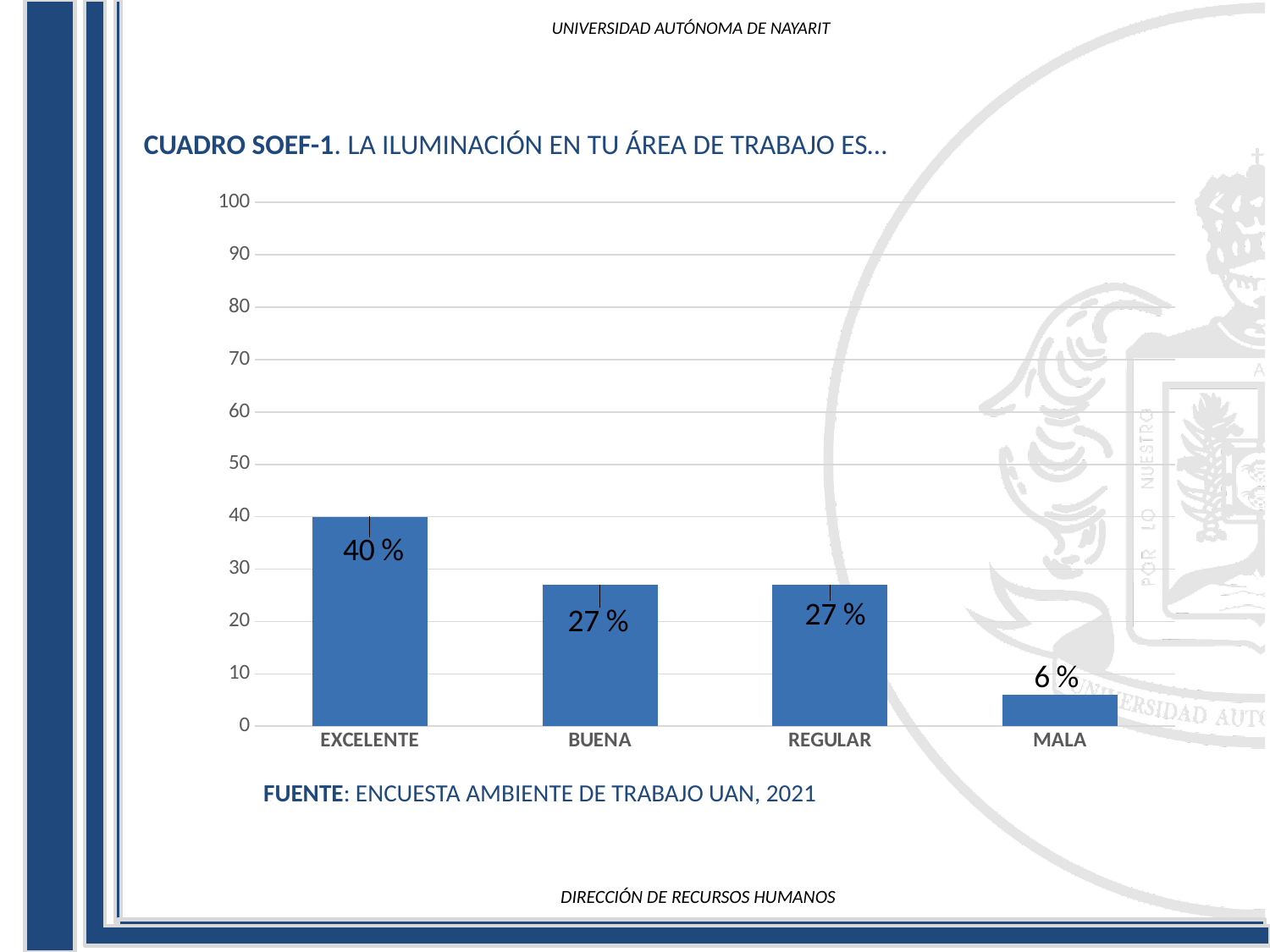
What is the value for EXCELENTE? 40 % Is the value for EXCELENTE greater or less than 30? greater What is the value for MALA? 6 % How many categories are shown on the x axis? 4 Which is larger, the value for BUENA or the value for MALA? BUENA Which category has the lowest value? MALA Which category has the highest value? EXCELENTE What is the source cited below the chart? ENCUESTA AMBIENTE DE TRABAJO UAN, 2021 What kind of chart is shown on the slide? bar chart What is the difference between the values for EXCELENTE and REGULAR? 13 % What is the value for BUENA? 27 % What is the difference between the values for EXCELENTE and MALA? 34 %